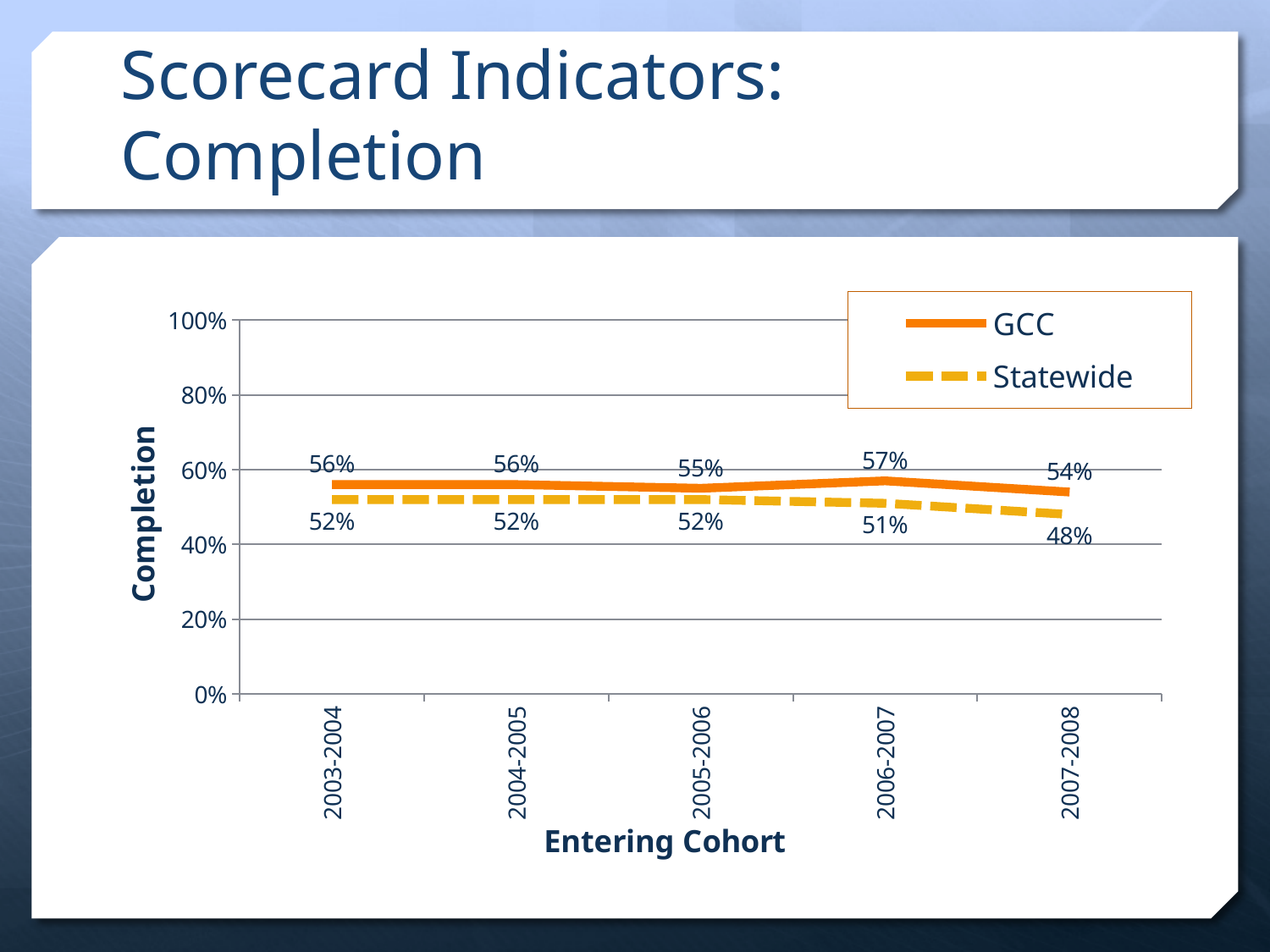
Does the Statewide completion rate rise or fall from the 2005-2006 cohort to the 2007-2008 cohort? fall How many entering cohorts are shown on the x axis? 5 How many series does the legend list? 2 Which is larger for the 2007-2008 cohort, the GCC completion rate or the Statewide completion rate? GCC Which entering cohort has the highest GCC completion rate? 2006-2007 What is the GCC completion rate for the 2006-2007 entering cohort? 57% What is the Statewide completion rate for the 2007-2008 entering cohort? 48% What is the GCC completion rate for the 2003-2004 entering cohort? 56% What kind of chart is shown on the slide? line chart What is the difference between the GCC and Statewide completion rates for the 2006-2007 cohort? 6% Is the Statewide completion rate for the 2005-2006 cohort greater or less than 60%? less Which entering cohort has the lowest Statewide completion rate? 2007-2008